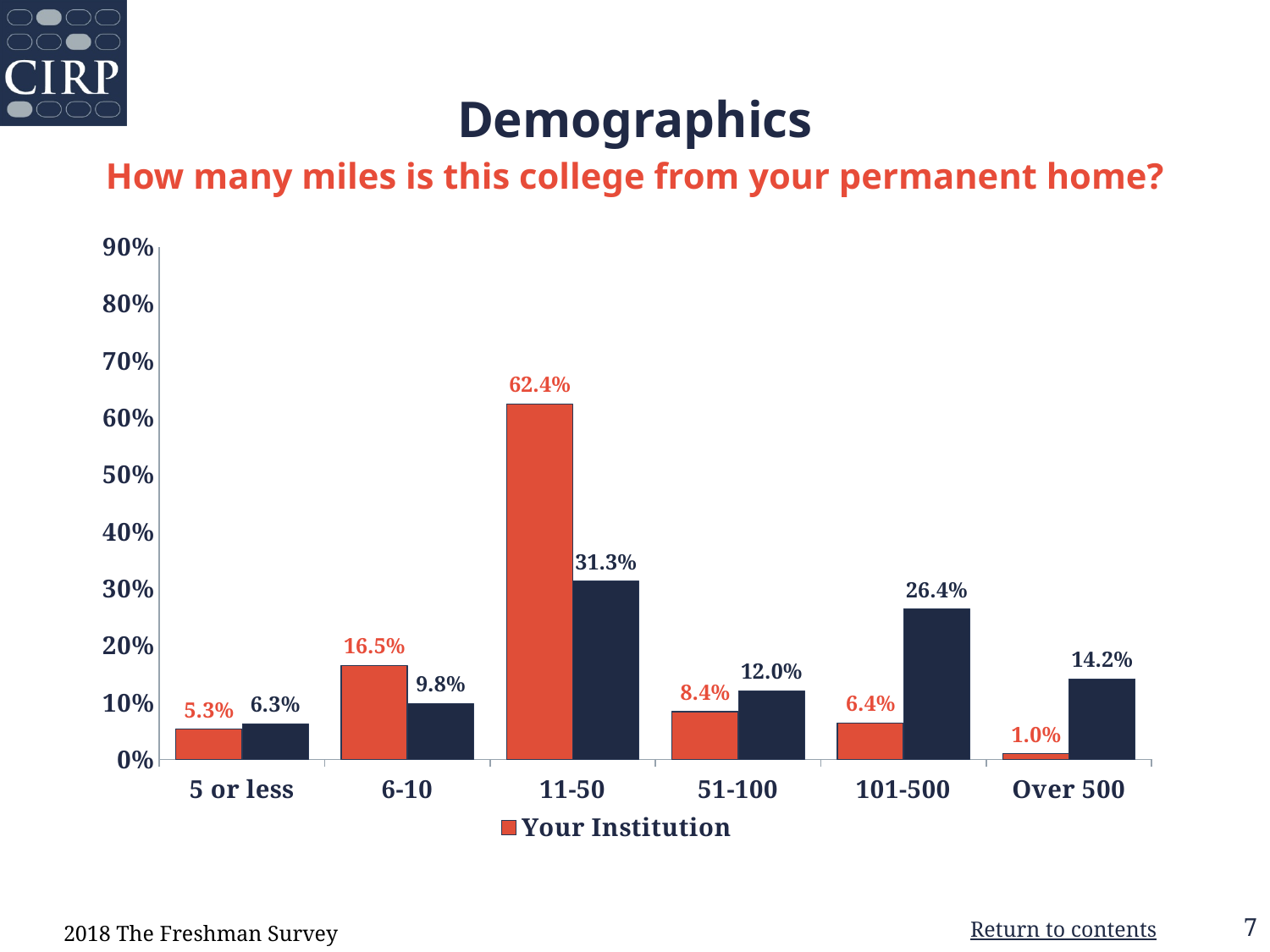
Which category has the highest Your Institution value? 11-50 What is the difference between the Your Institution values for 11-50 and 6-10? 45.9% How many distance categories are shown on the x axis? 6 Is the Your Institution value for 11-50 greater or less than 60%? greater Which is larger for Your Institution: 51-100 or 101-500? 51-100 What is the question shown as the chart's subtitle? How many miles is this college from your permanent home? How many series does the legend list? 1 What is the Your Institution value for the 6-10 miles category? 16.5% What is the Your Institution value for the Over 500 miles category? 1.0% What is the Your Institution value for the 11-50 miles category? 62.4% Which category has the lowest Your Institution value? Over 500 What kind of chart is shown on the slide? bar chart